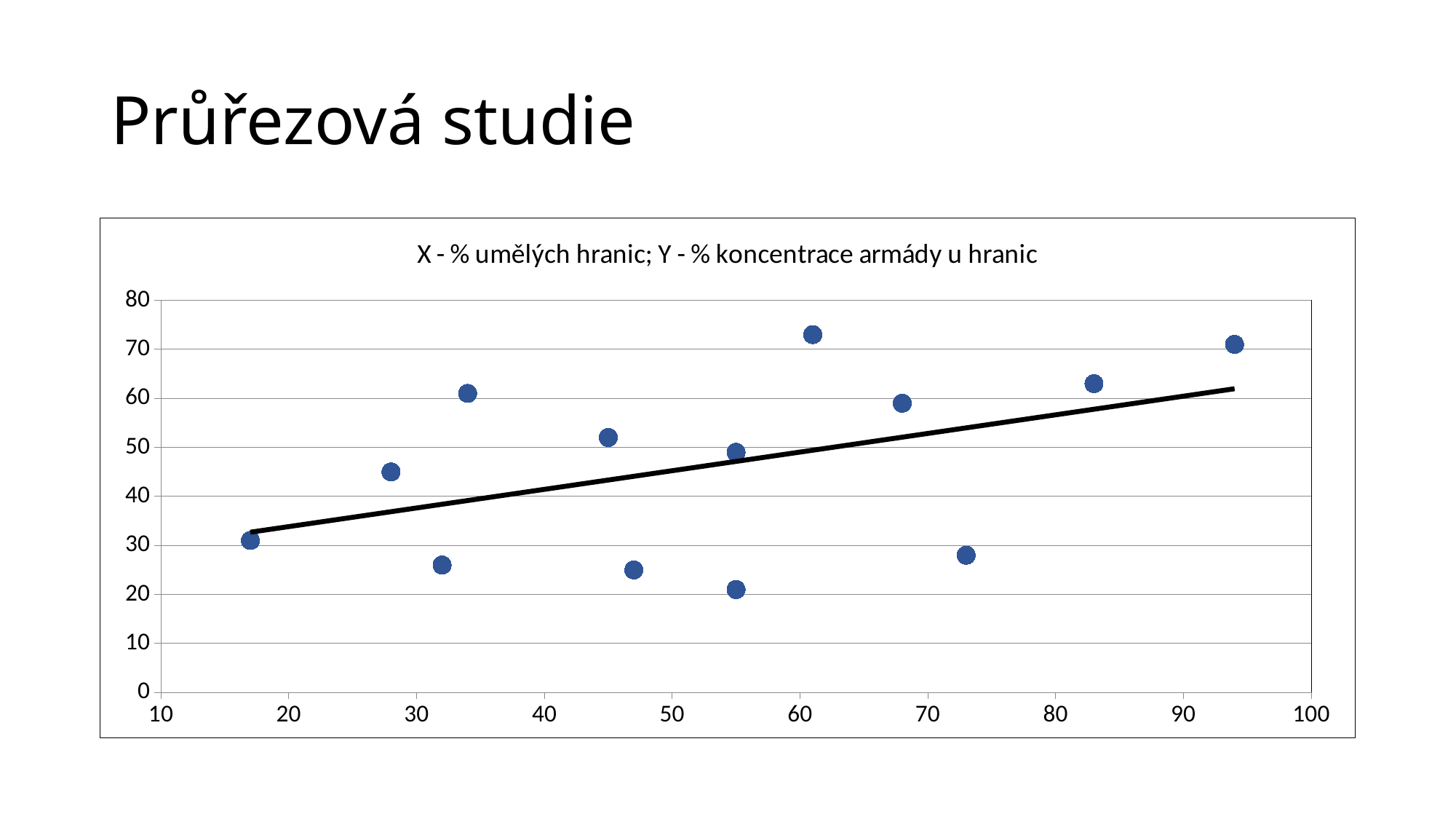
How many data points are plotted on the chart? 13 Is the y value of the point at x ≈ 17 greater or less than 40? less What is the highest value shown on the y axis? 80 Is the y value of the point at x ≈ 34 greater or less than 50? greater Is the y value of the point at x ≈ 61 greater or less than 70? greater Does the trend line on the chart rise or fall as x increases? rises What kind of chart is shown on the slide? scatter chart What is the title of the chart? X - % umělých hranic; Y - % koncentrace armády u hranic Which is larger: the y value of the point at x ≈ 34 or the y value of the point at x ≈ 32? the point at x ≈ 34